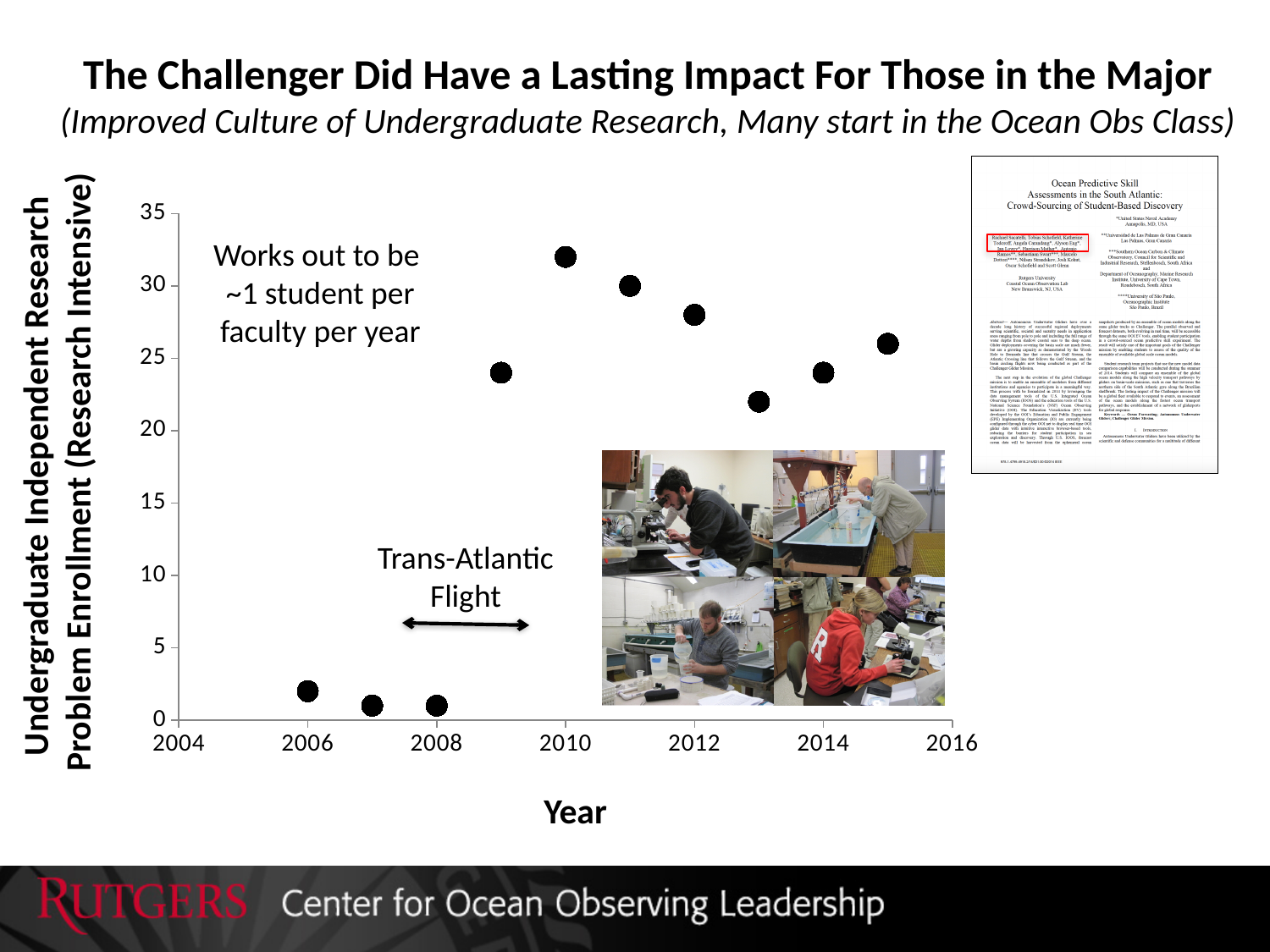
Which year has the larger enrollment value, 2008 or 2012? 2012 Which year has the larger enrollment value, 2011 or 2013? 2011 Is the value for 2010 greater or less than 30? greater What kind of chart is shown on the slide? scatter plot Is the value for 2006 greater or less than 5? less Which year has the highest undergraduate independent research problem enrollment? 2010 Is the value for 2013 greater or less than 20? greater How many data points are plotted on the chart? 10 What is the title of the x axis? Year Do the enrollment values generally rise or fall from 2006 to 2015? rise